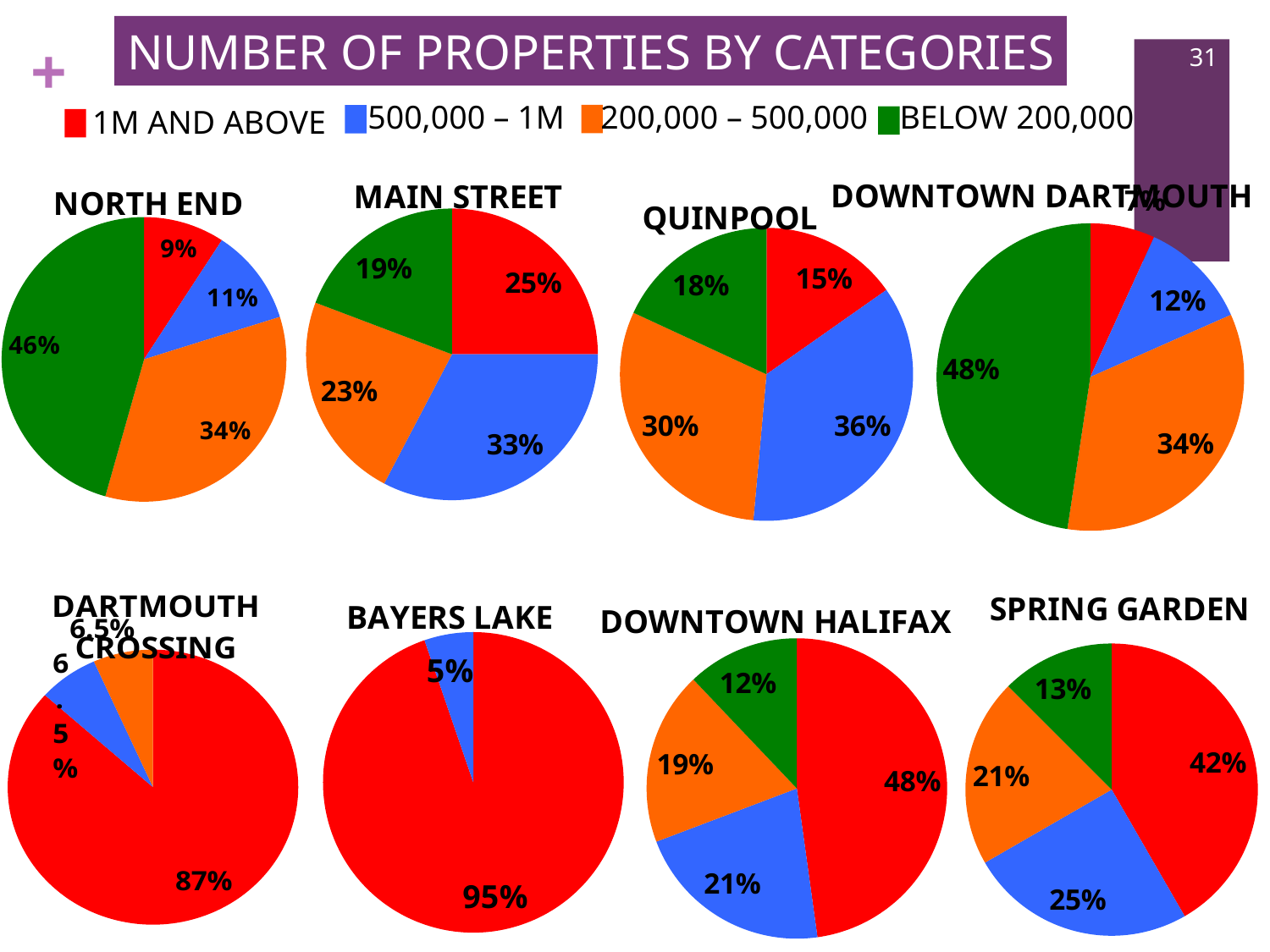
In the North End pie chart, what share of properties is in the BELOW 200,000 category? 46% In the Downtown Halifax pie chart, which category has the smallest share? BELOW 200,000 In the Quinpool pie chart, which is larger: the 200,000 – 500,000 share or the BELOW 200,000 share? 200,000 – 500,000 Which colour represents the 1M AND ABOVE category in the legend? Red In the Spring Garden pie chart, what is the difference between the 1M AND ABOVE share and the 500,000 – 1M share? 17% How many pie charts are shown on the slide? 8 In the Downtown Dartmouth pie chart, what share of properties is in the 200,000 – 500,000 category? 34% How many categories does the legend list? 4 In the Main Street pie chart, what share of properties is in the 500,000 – 1M category? 33% What kind of chart is used for each location on this slide? Pie chart In the Bayers Lake pie chart, what share of properties is in the 1M AND ABOVE category? 95% In the Quinpool pie chart, which category has the largest share? 500,000 – 1M